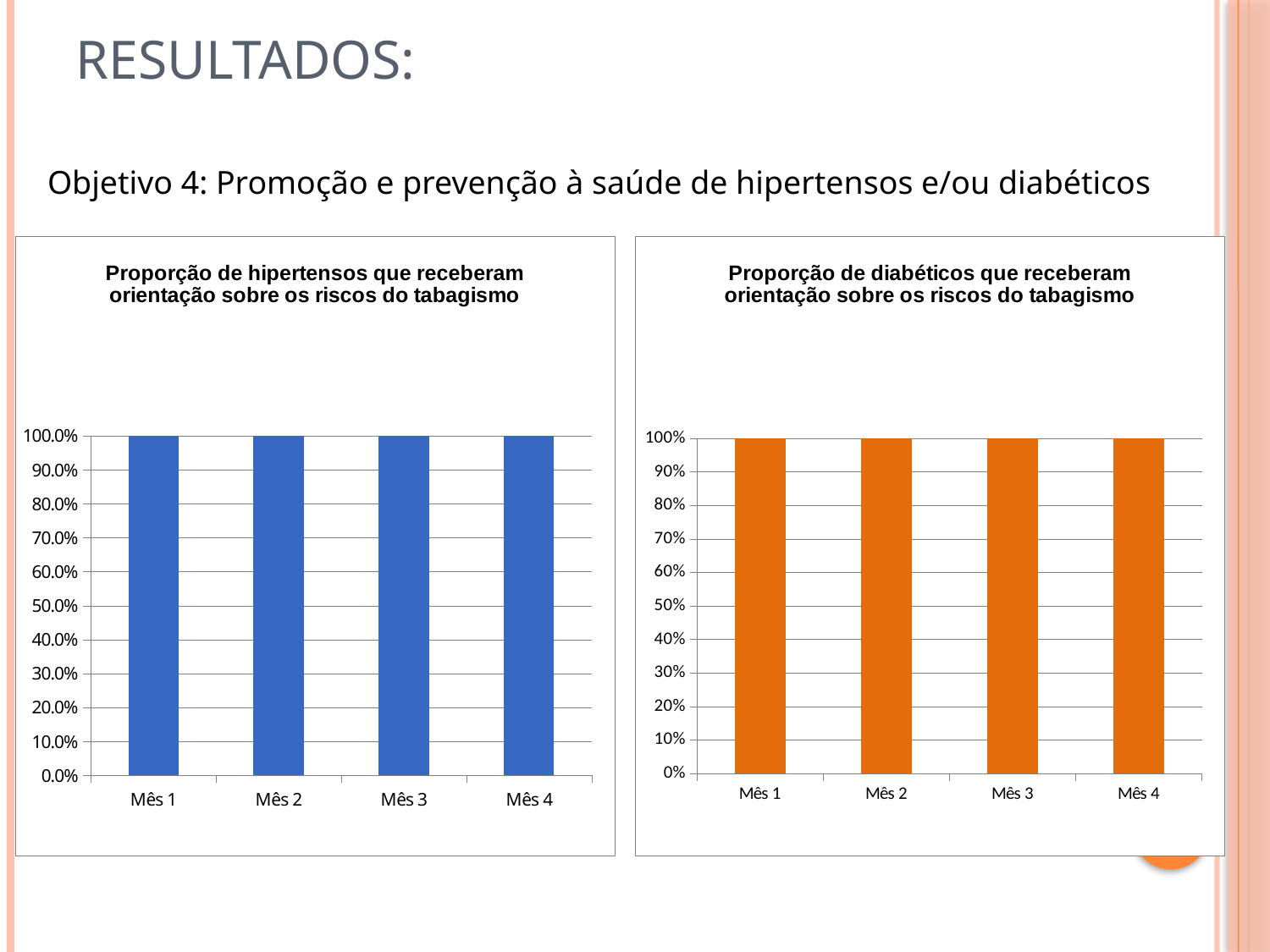
What kind of chart is the right chart about diabéticos? Bar chart How many categories (months) are shown in the left chart about hipertensos? 4 In the left chart, 'Proporção de hipertensos que receberam orientação sobre os riscos do tabagismo', what is the value for Mês 4? 100.0% What colour are the bars in the left chart about hipertensos? Blue In the right chart about diabéticos, is the value for Mês 1 greater or less than 90%? greater In the left chart about hipertensos, do the values rise, fall or stay the same from Mês 1 to Mês 4? Stay the same In the right chart, 'Proporção de diabéticos que receberam orientação sobre os riscos do tabagismo', what is the value for Mês 2? 100% In the right chart, 'Proporção de diabéticos que receberam orientação sobre os riscos do tabagismo', what is the value for Mês 3? 100% In the left chart, 'Proporção de hipertensos que receberam orientação sobre os riscos do tabagismo', what is the value for Mês 1? 100.0% What is the title of the right chart? Proporção de diabéticos que receberam orientação sobre os riscos do tabagismo How many bars are plotted in the right chart about diabéticos? 4 What kind of chart is the left chart about hipertensos? Bar chart